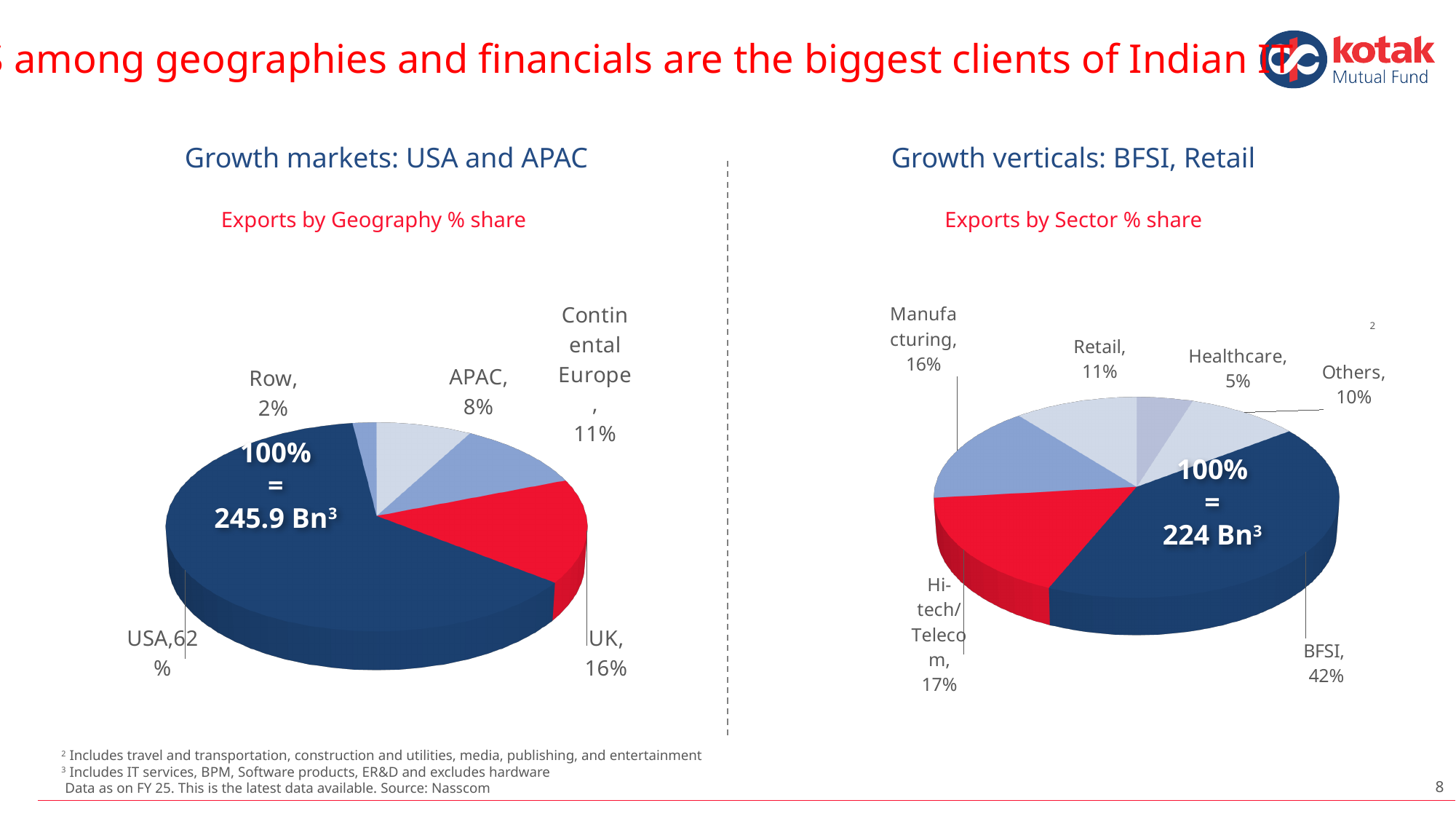
What type of chart is used for 'Exports by Sector % share'? Pie chart In the 'Exports by Geography % share' chart, how many geography slices are shown? 5 In the 'Exports by Sector % share' chart, how many sector slices are shown? 6 In the 'Exports by Geography % share' chart, what is the difference in share between Continental Europe and APAC? 3% In the 'Exports by Geography % share' chart, which geography has the smallest share? Row In the 'Exports by Geography % share' chart, what total value does 100% represent? 245.9 Bn In the 'Exports by Sector % share' chart, which sector has the smallest share? Healthcare In the 'Exports by Geography % share' chart, what share does the USA hold? 62% In the 'Exports by Sector % share' chart, which sector has the largest share? BFSI In the 'Exports by Geography % share' chart, what is the share for the UK? 16% In the 'Exports by Sector % share' chart, what share does BFSI hold? 42% In the 'Exports by Sector % share' chart, which is larger: Hi-tech/Telecom or Retail? Hi-tech/Telecom